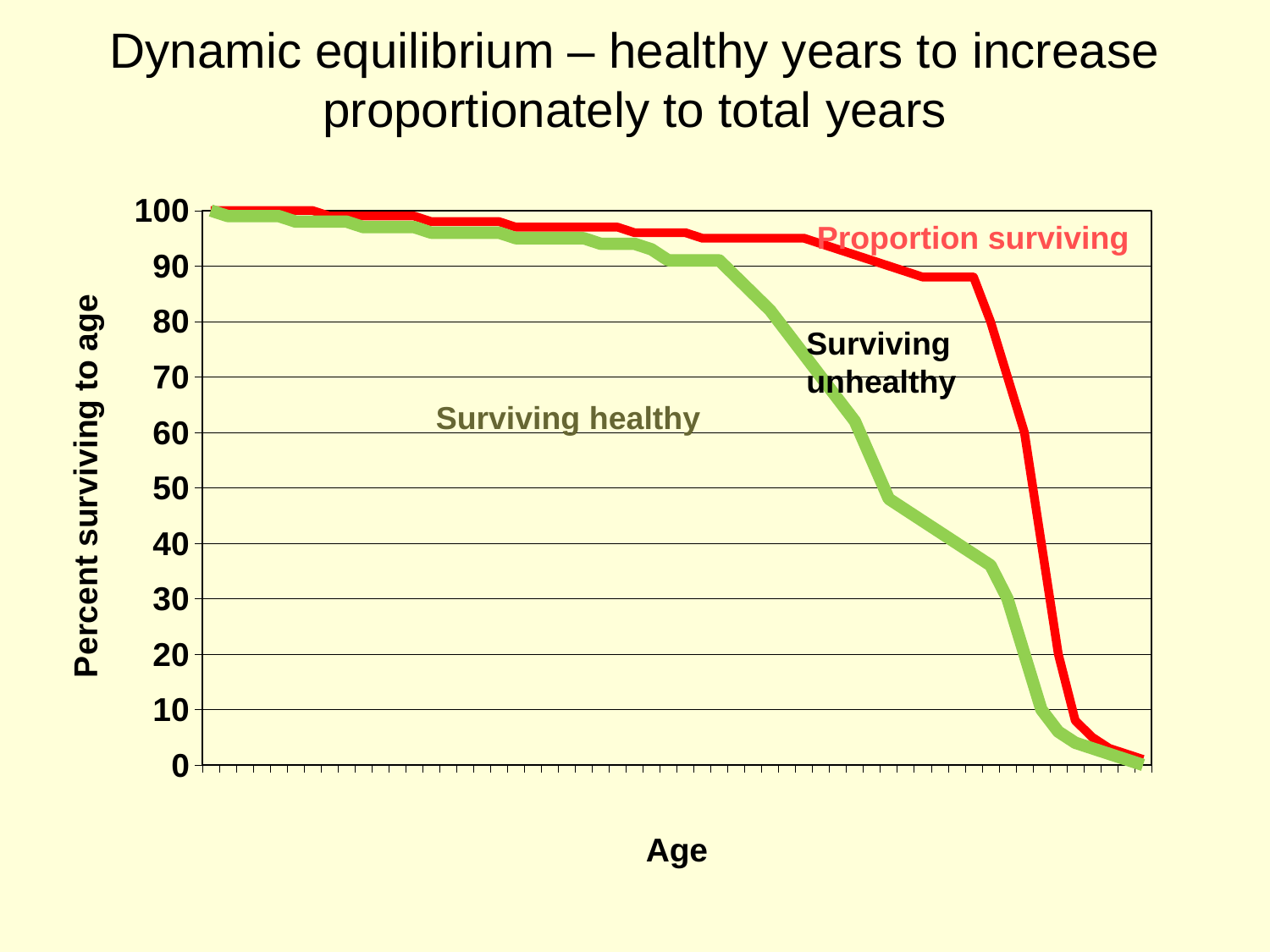
What kind of chart is shown on the slide? line chart Which line is higher across the chart, 'Proportion surviving' or 'Surviving healthy'? Proportion surviving How many lines (series) are plotted on the chart? 2 What is the label of the red line? Proportion surviving At what value on the y axis do both lines start at the left edge of the chart? 100 What is the label of the green line? Surviving healthy Do the values of the 'Surviving healthy' line rise or fall as age increases along the x axis? fall What is the highest value shown on the y axis? 100 Do the values of the 'Proportion surviving' line rise or fall as age increases along the x axis? fall